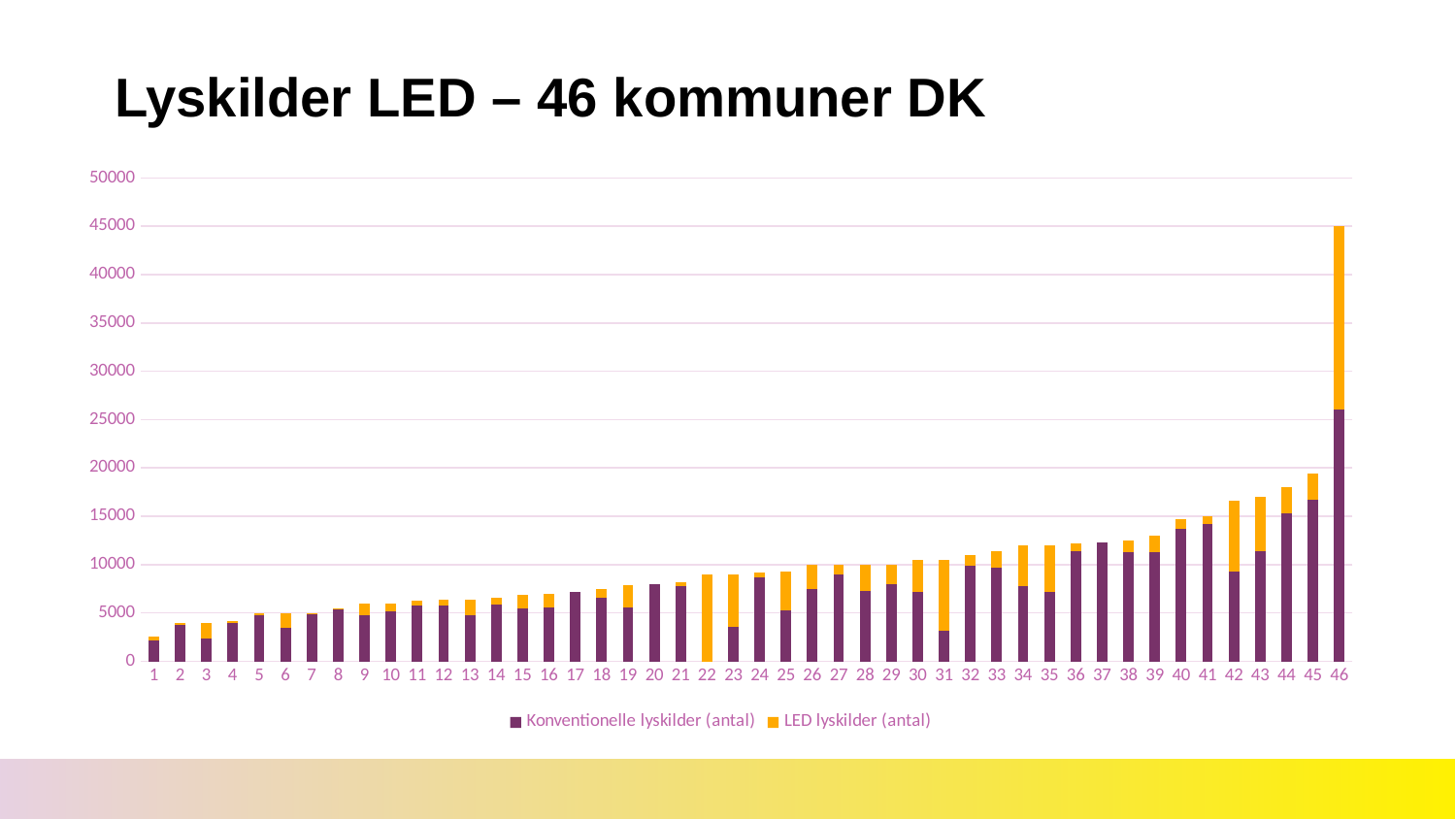
Which category has the larger total bar, 22 or 45? 45 What is the title of the slide containing the chart? Lyskilder LED – 46 kommuner DK What kind of chart is shown on the slide? stacked bar chart Which category has the lowest total bar? 1 How many categories are shown along the x axis of the chart? 46 Do the total bar heights generally rise or fall from category 1 to category 46? rise Is the total value for category 1 greater or less than 5000? less Which colour represents the LED lyskilder (antal) series in the chart? orange Is the Konventionelle lyskilder (antal) value for category 46 greater or less than 20000? greater How many series does the legend list? 2 Is the total value for category 46 greater or less than 40000? greater Which category has the highest total bar? 46